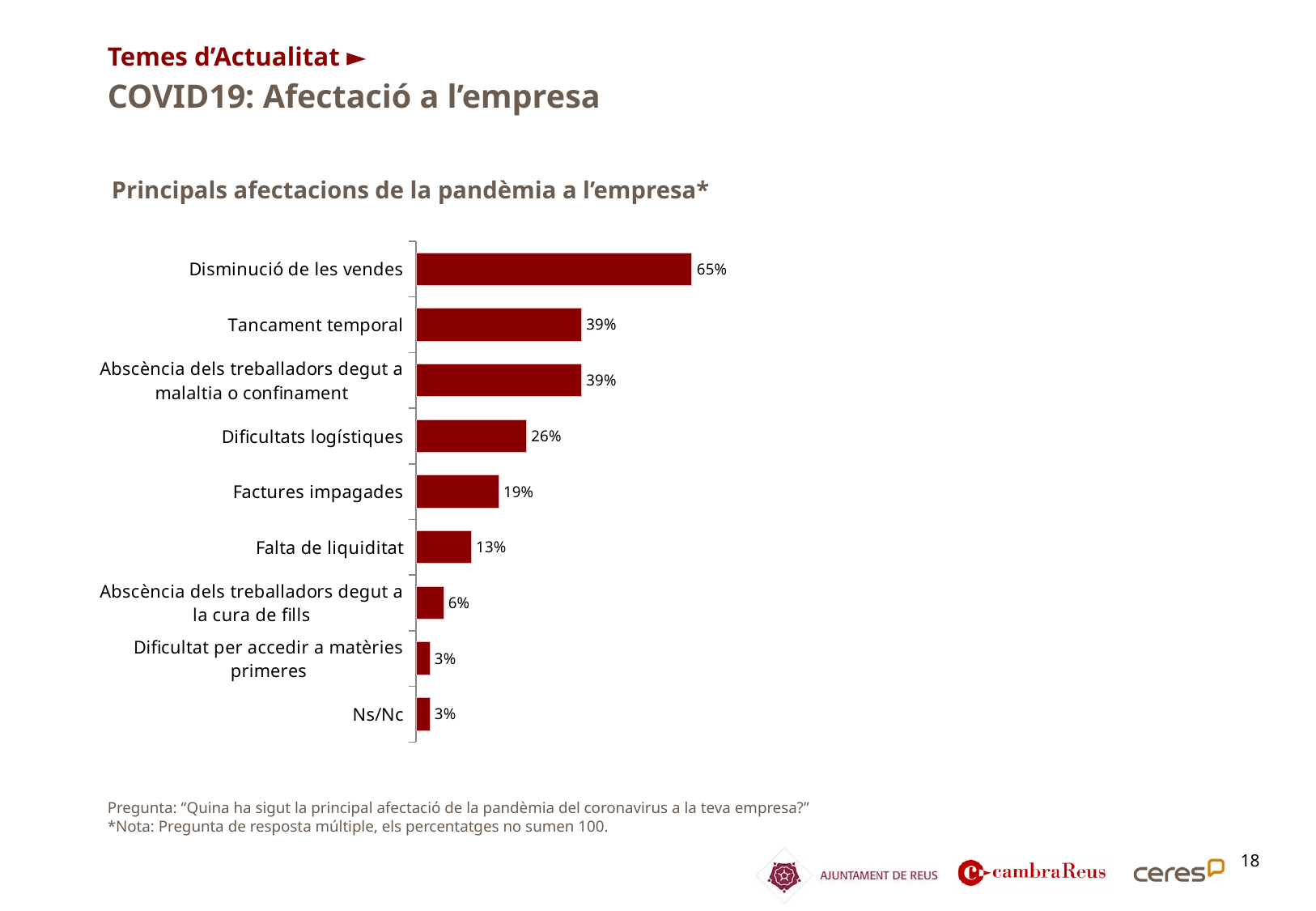
Which is larger, "Dificultats logístiques" or "Factures impagades"? Dificultats logístiques What is the title of the chart? Principals afectacions de la pandèmia a l'empresa* What is the value for "Dificultats logístiques"? 26% What kind of chart is shown on the slide? Bar chart What is the value for "Factures impagades"? 19% What is the value for "Abscència dels treballadors degut a la cura de fills"? 6% Which category has the highest value? Disminució de les vendes What is the value for "Disminució de les vendes"? 65% What colour are the bars in the chart? Dark red How many categories are shown in the chart? 9 What is the difference between "Disminució de les vendes" and "Tancament temporal"? 26% What is the difference between "Falta de liquiditat" and "Ns/Nc"? 10%